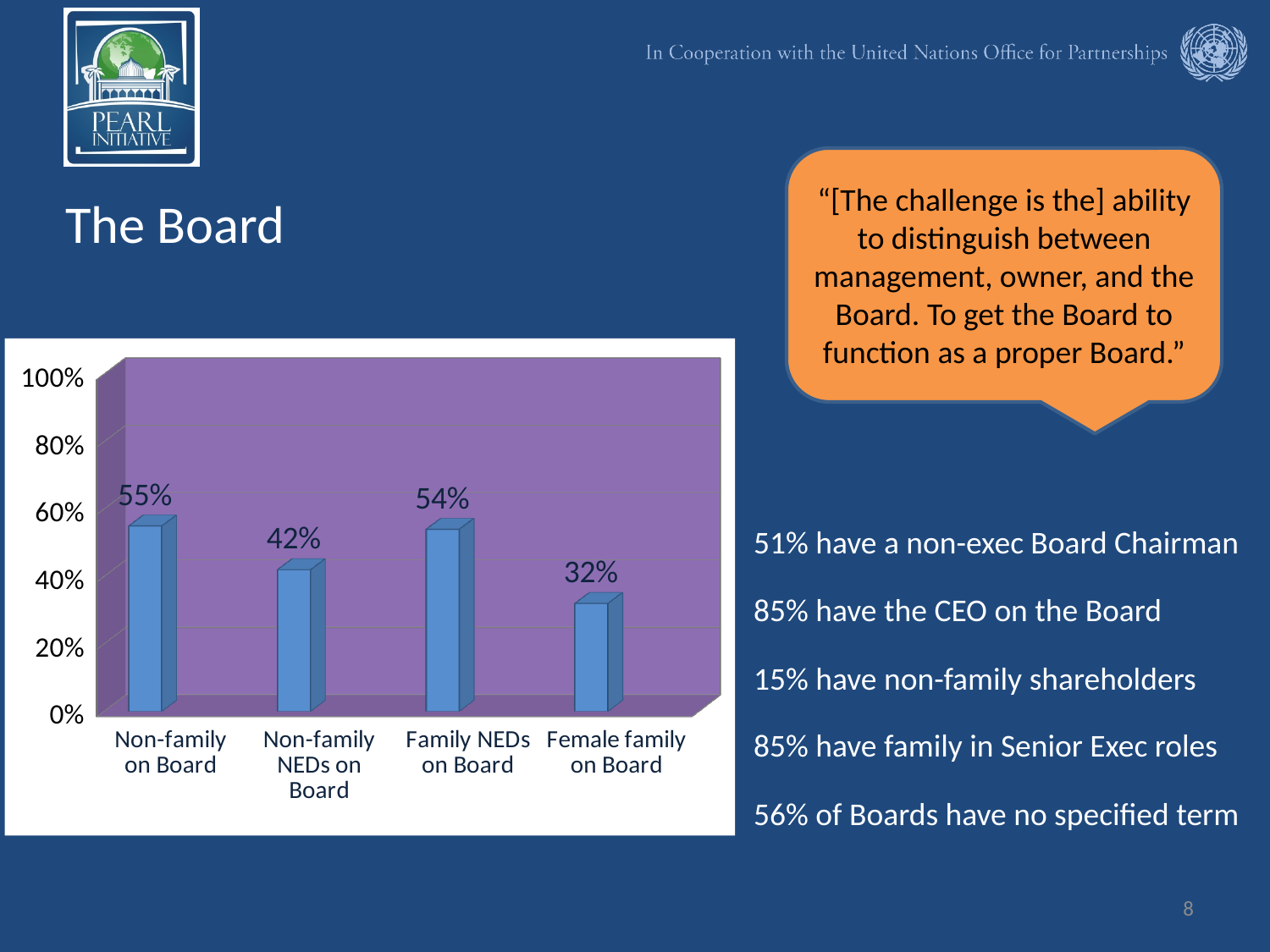
How many categories are shown in the chart? 4 Which is larger, the value for Non-family NEDs on Board or Female family on Board? Non-family NEDs on Board Is the value for Non-family NEDs on Board greater or less than 40%? greater What is the value for Female family on Board? 32% What kind of chart is shown on the slide? bar chart What is the value for Family NEDs on Board? 54% What is the value for Non-family NEDs on Board? 42% What is the difference between the values for Family NEDs on Board and Non-family NEDs on Board? 12% What is the value for Non-family on Board? 55% Which category has the highest value? Non-family on Board Which category has the lowest value? Female family on Board What is the difference between the values for Non-family on Board and Female family on Board? 23%